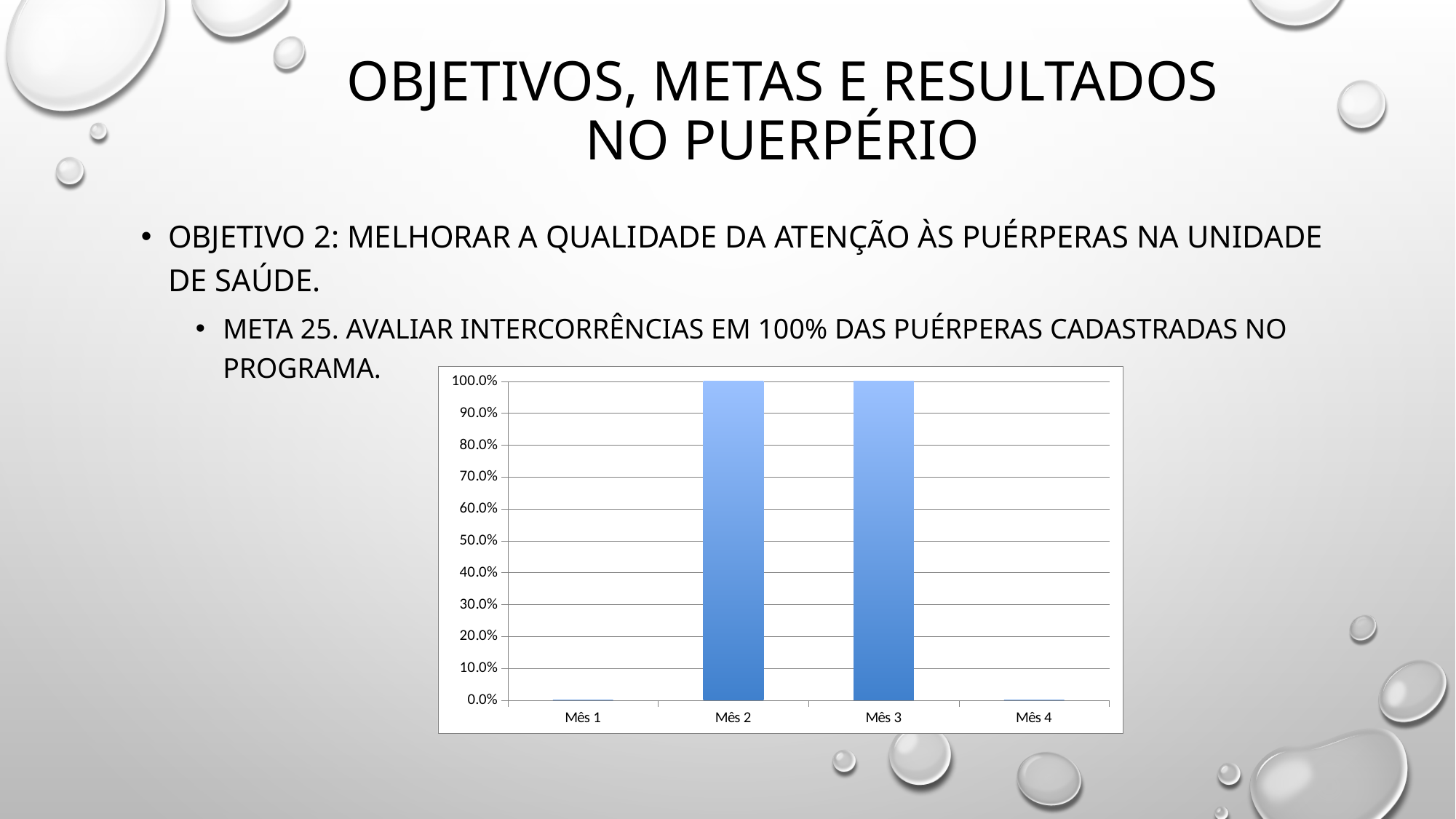
Which is larger, the value for Mês 1 or the value for Mês 3? Mês 3 What is the label of the first category on the x axis of the chart? Mês 1 What is the value for Mês 4 in the chart? 0.0% Is the value for Mês 2 greater or less than 50.0%? greater What is the value for Mês 3 in the chart? 100.0% What is the value for Mês 2 in the chart? 100.0% What is the difference between the values for Mês 2 and Mês 1? 100.0% What kind of chart is shown on the slide? bar chart How many categories are shown on the x axis of the chart? 4 What is the highest value shown on the y axis of the chart? 100.0% Is the value for Mês 4 greater or less than 10.0%? less What is the value for Mês 1 in the chart? 0.0%